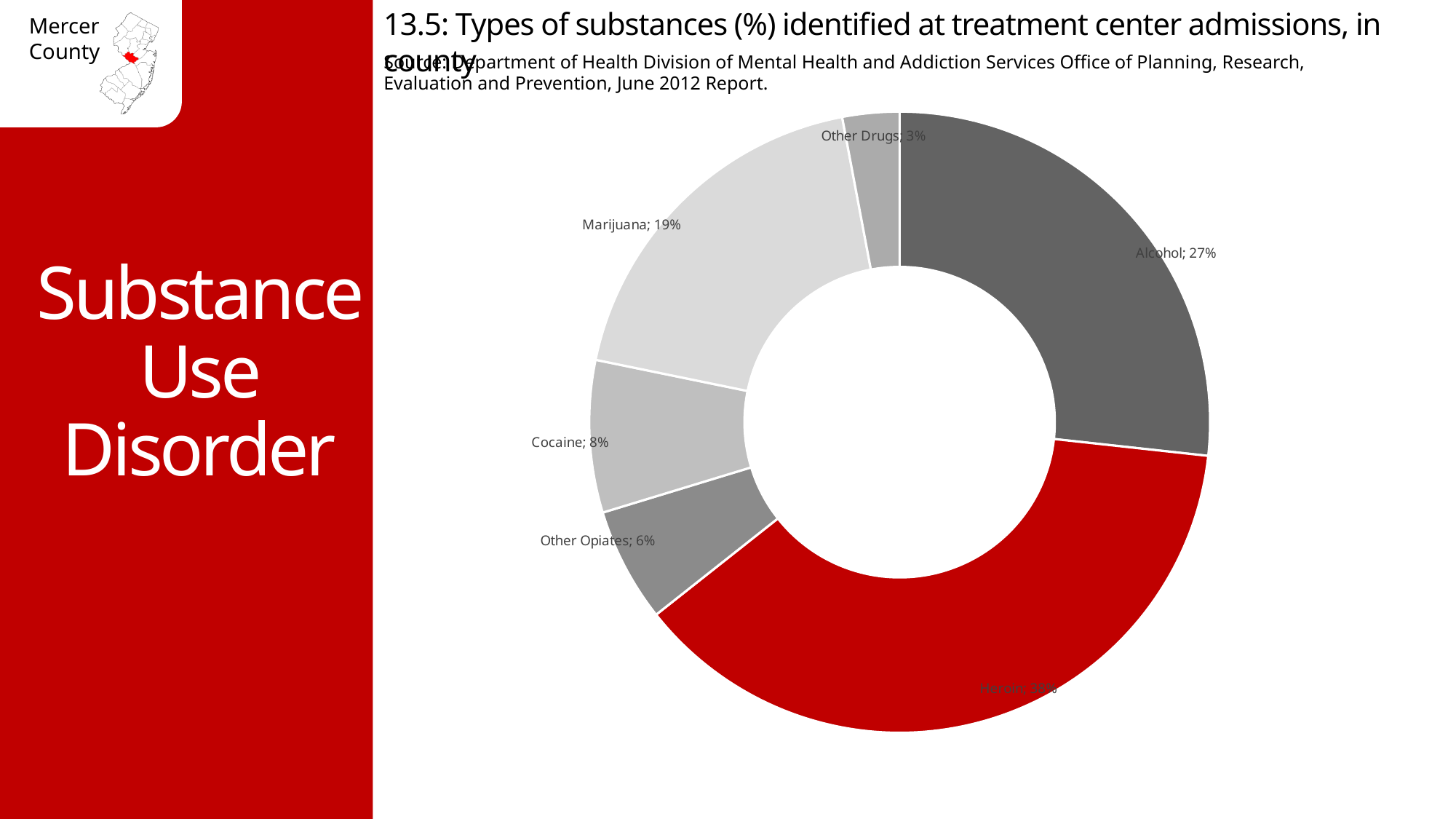
What colour is the Heroin slice? red What percentage is shown for Other Drugs? 3% What percentage is shown for Marijuana? 19% Which substance has the smallest share of admissions? Other Drugs How many percentage points higher is Alcohol than Marijuana? 8 What percentage of treatment center admissions identified Alcohol? 27% What percentage is shown for Cocaine? 8% Which substance has the largest share of admissions? Heroin Which has a larger share, Cocaine or Other Opiates? Cocaine What kind of chart is shown on the slide? doughnut (pie) chart How many substance categories are shown in the chart? 6 What percentage is shown for Other Opiates? 6%